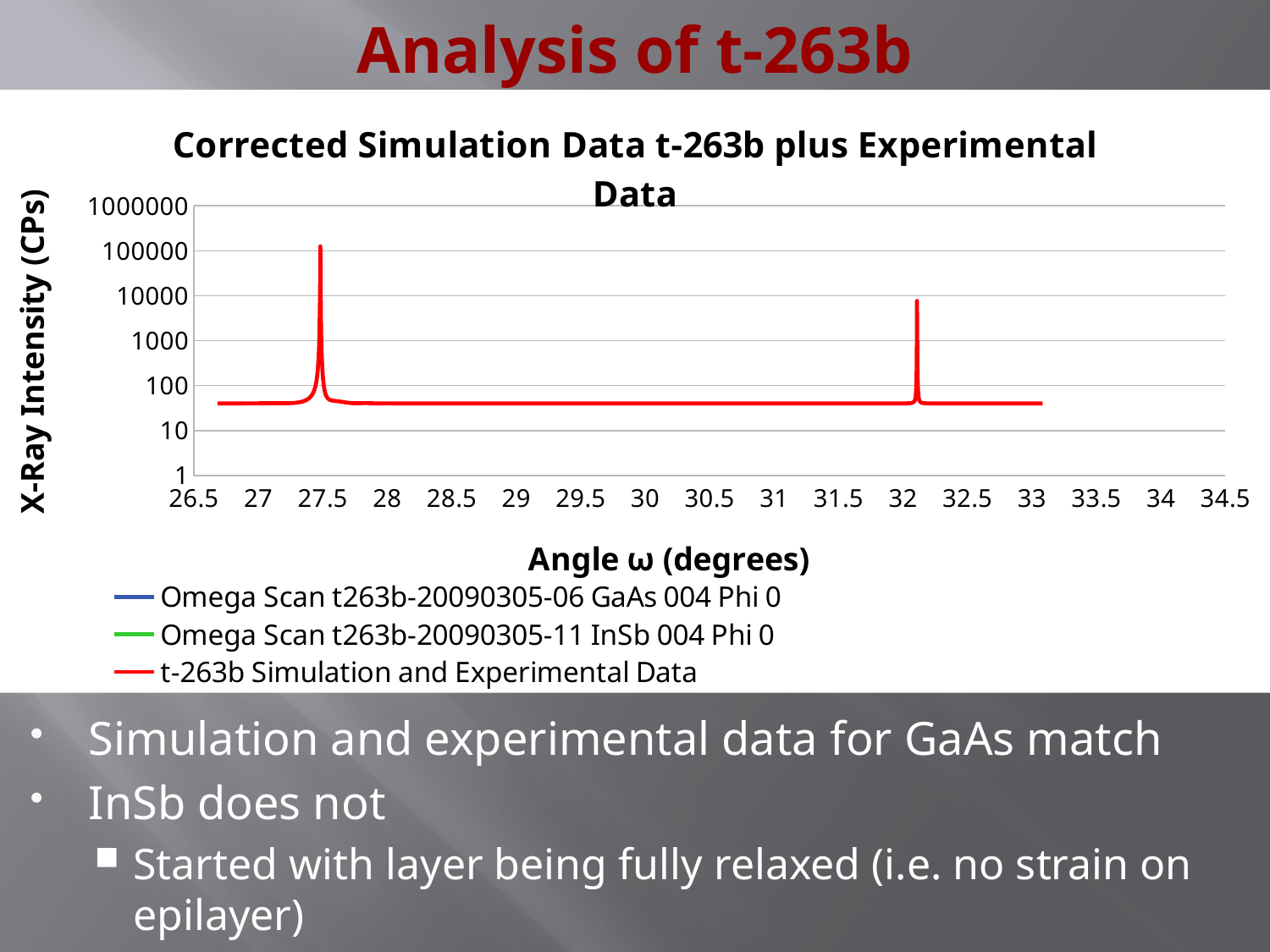
Is the baseline X-Ray Intensity between the two peaks (e.g. at 30 degrees) greater or less than 100? less Near which x-axis tick does the highest X-Ray Intensity occur? 27.5 How many sharp peaks are visible in the plotted red line? 2 Is the baseline X-Ray Intensity at 30 degrees greater or less than 10? greater What kind of chart is shown on the slide? line chart How many series does the chart legend list? 3 Is the X-Ray Intensity at the peak near 32 degrees greater or less than 1000? greater What is the title of the chart? Corrected Simulation Data t-263b plus Experimental Data Which peak has the higher X-Ray Intensity, the one near 27.5 degrees or the one near 32 degrees? the one near 27.5 degrees What is the label on the y-axis of the chart? X-Ray Intensity (CPs)